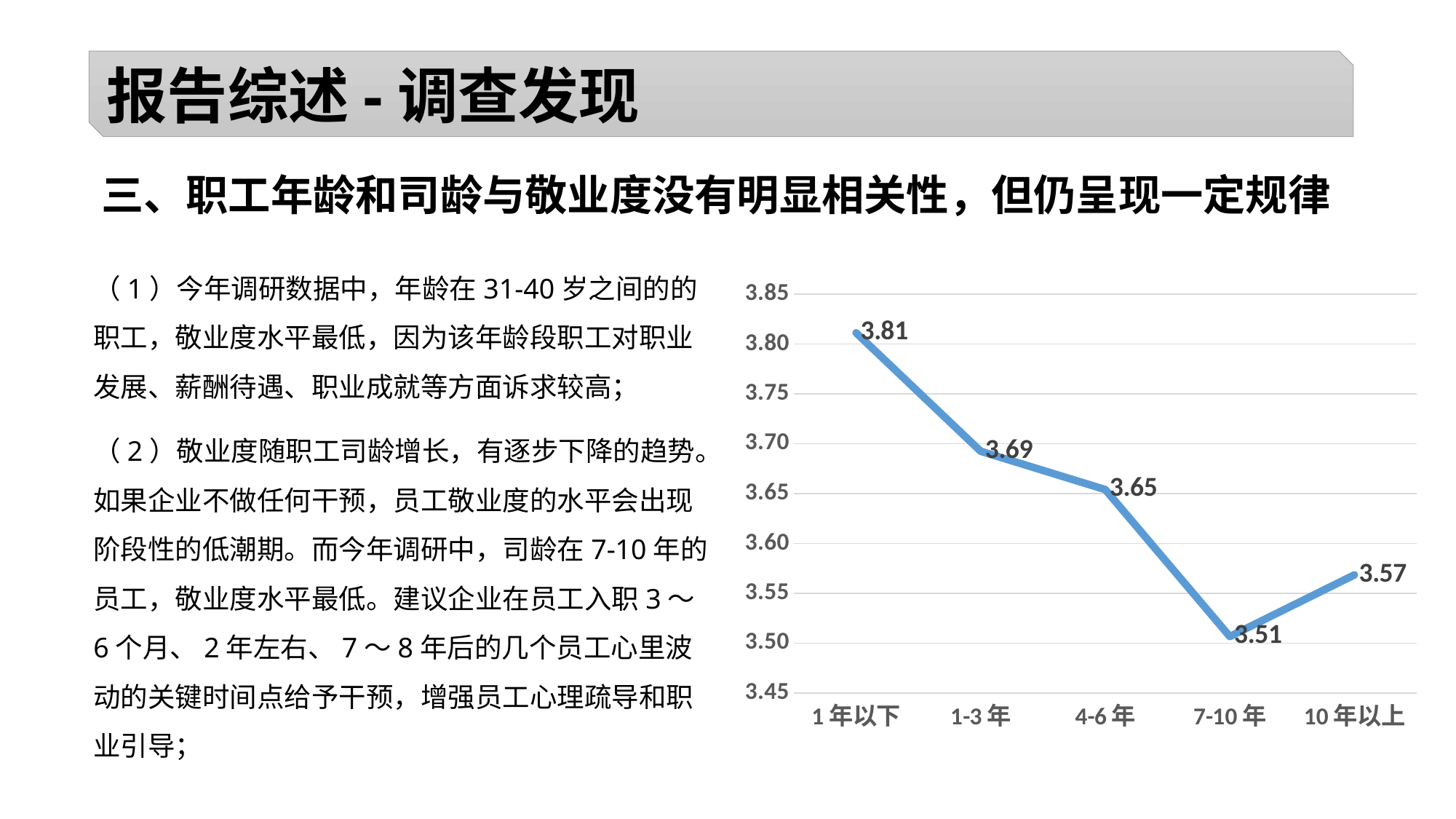
What kind of chart is shown on the slide? line chart Which category has the highest value? 1年以下 Do the values rise or fall from 1年以下 to 7-10年? fall Which category has the lowest value? 7-10年 How many categories are shown on the x axis? 5 What is the value for 1年以下? 3.81 What is the difference between the values for 1-3年 and 4-6年? 0.04 Is the value for 1-3年 greater or less than 3.70? less What is the difference between the values for 1年以下 and 7-10年? 0.30 What is the value for 4-6年? 3.65 What is the value for 10年以上? 3.57 Which is larger, the value for 10年以上 or the value for 7-10年? 10年以上